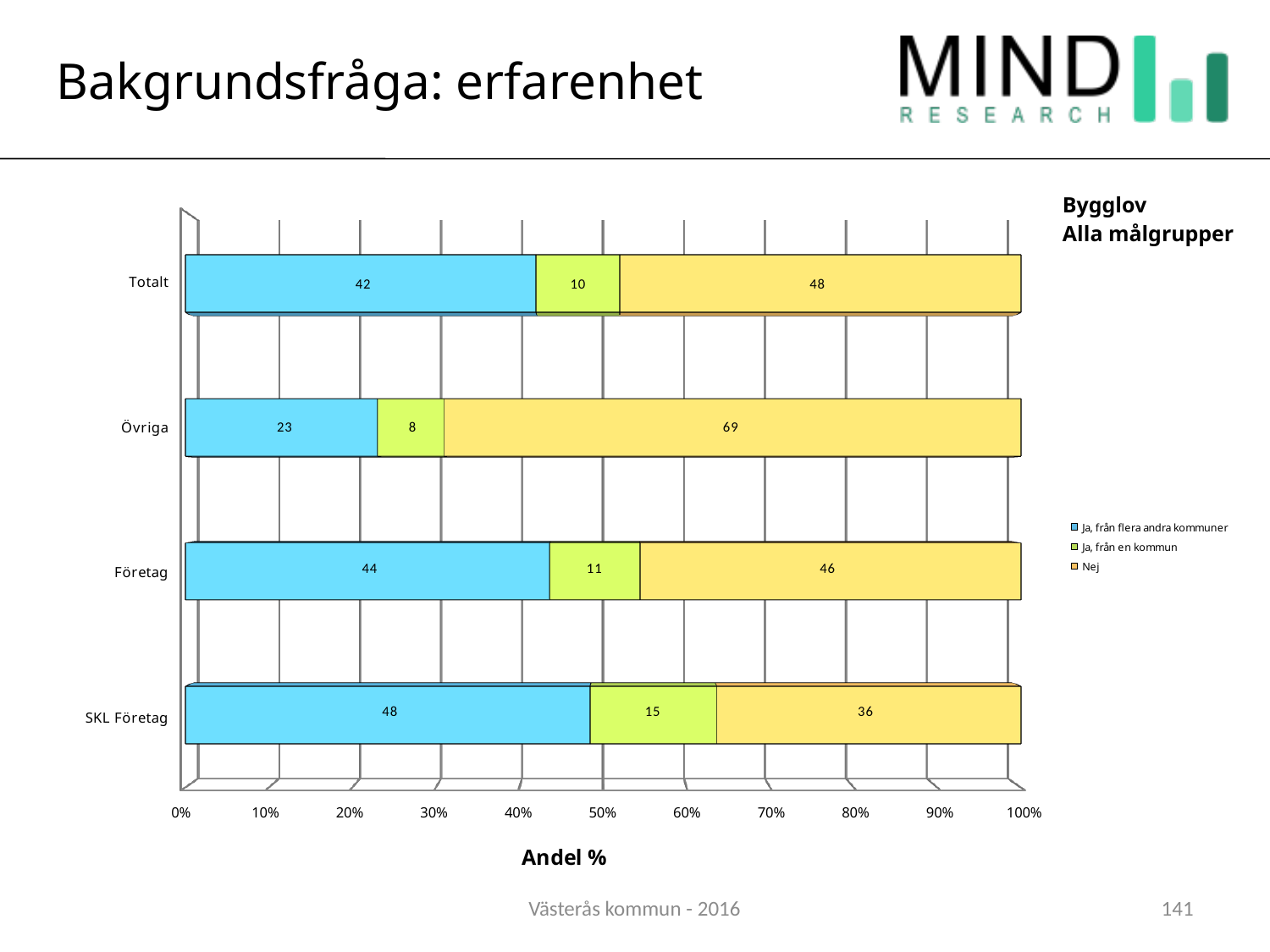
What kind of chart is shown on the slide? Stacked bar chart Which category has the lowest value for 'Ja, från flera andra kommuner'? Övriga What is the title of the horizontal axis of the chart? Andel % What is the value of 'Nej' for Övriga? 69 What is the value of 'Ja, från en kommun' for Företag? 11 How many series does the legend list? 3 How many categories are shown on the vertical axis of the chart? 4 What is the value of 'Ja, från flera andra kommuner' for SKL Företag? 48 What is the difference between the 'Nej' values for Övriga and SKL Företag? 33 Which is larger: the 'Ja, från en kommun' value for SKL Företag or for Totalt? SKL Företag Which category has the highest value for 'Nej'? Övriga What is the total of the stacked bar for Företag? 101